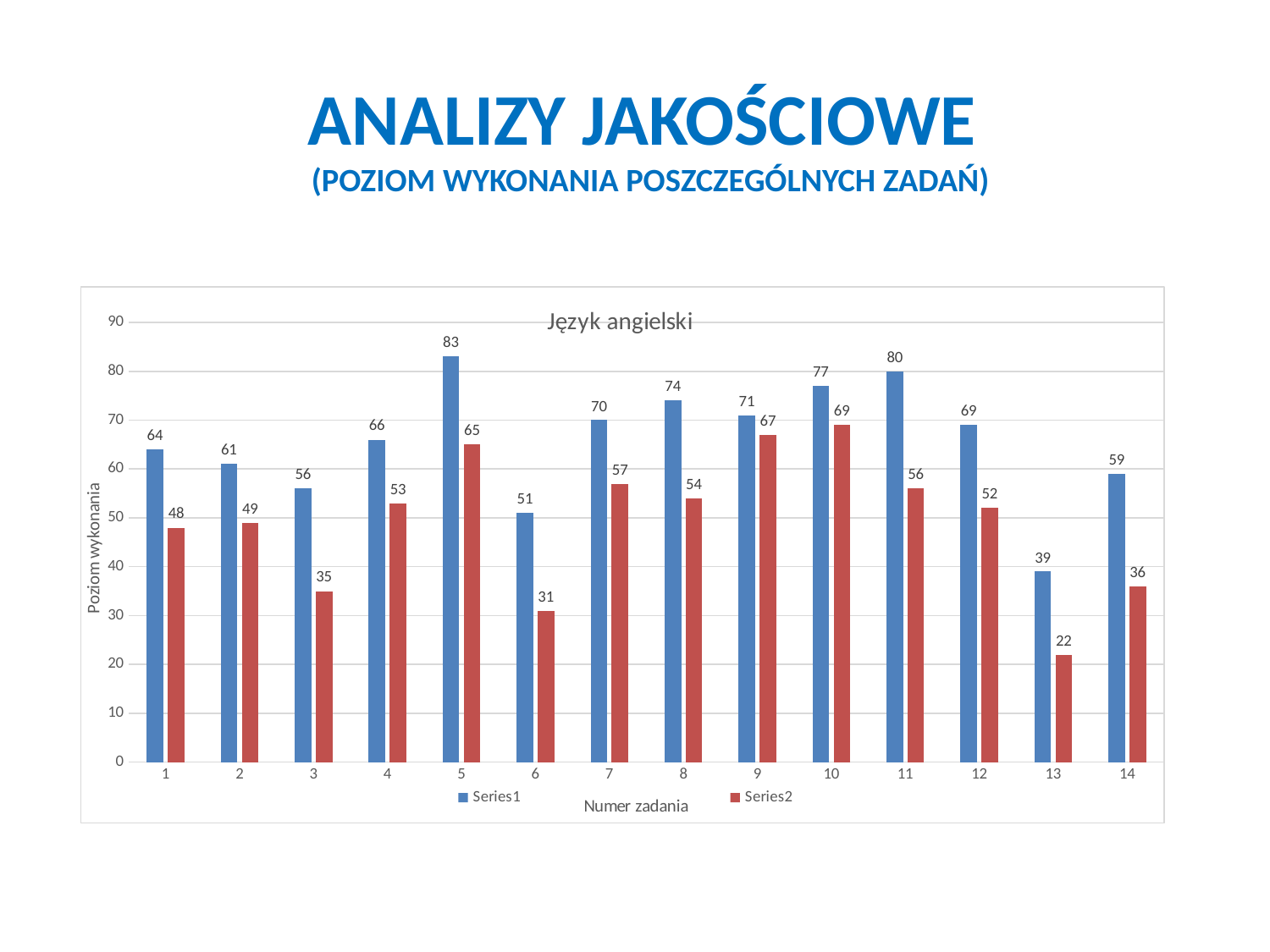
What is the title of the chart? Język angielski What is the Series1 value for task 5? 83 How many task numbers are shown on the x axis? 14 How many series does the legend list? 2 What is the Series2 value for task 13? 22 Which is larger for task 3: the Series1 value or the Series2 value? Series1 Which task number has the lowest Series2 value? 13 What kind of chart is shown on the slide? bar chart What is the Series2 value for task 9? 67 Is the Series1 value for task 11 greater or less than 70? greater What is the difference between the Series1 and Series2 values for task 6? 20 Which task number has the highest Series1 value? 5